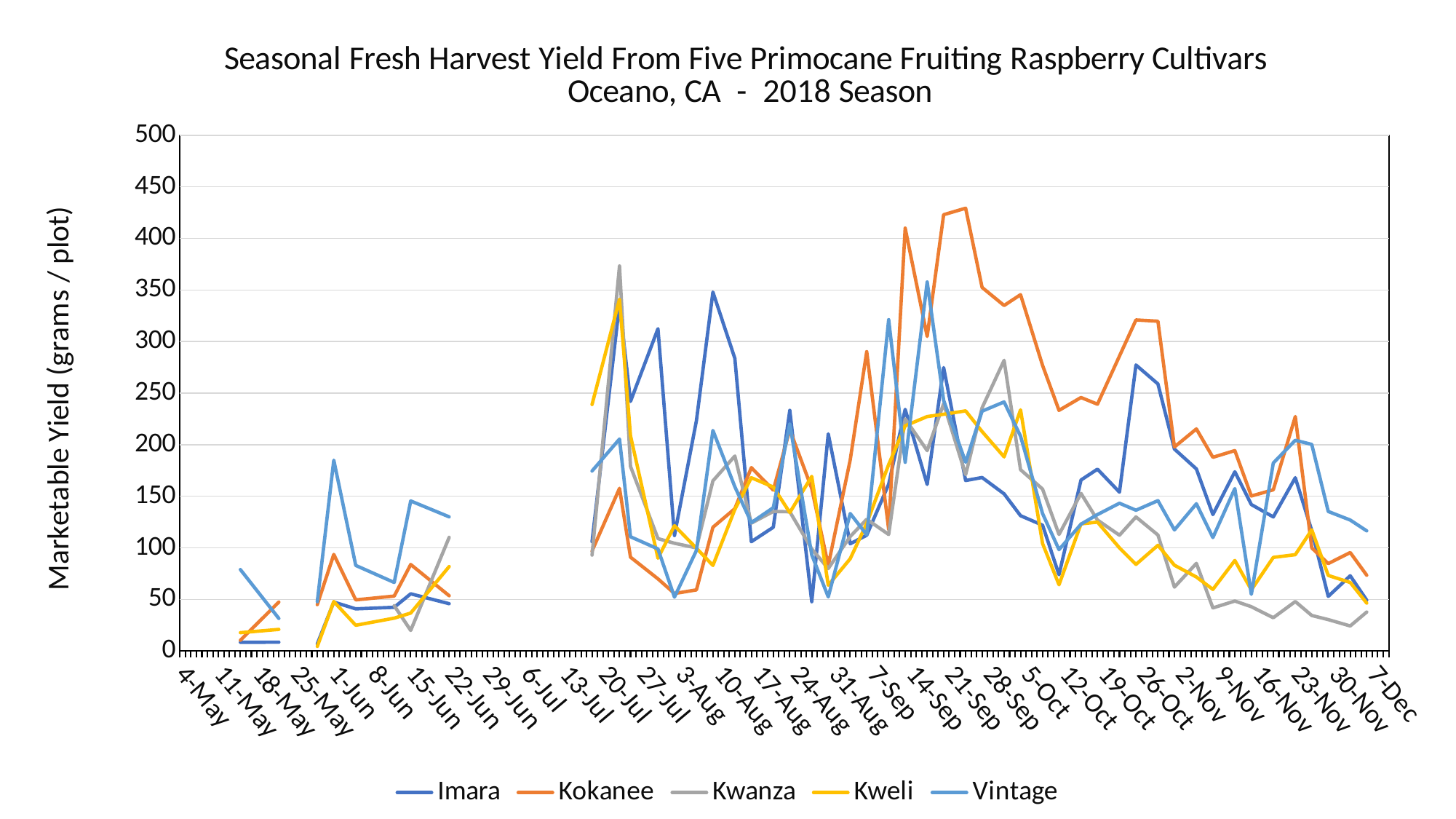
Which cultivar has the highest value at 7-Dec, the last point on the chart? Vintage What is the label on the vertical axis? Marketable Yield (grams / plot) How many series does the legend list? 5 What kind of chart is shown on the slide? line chart Around 21-Sep, which line is higher, Kokanee or Kweli? Kokanee Is the highest value reached by the Imara line greater or less than 300? greater What is the title of the chart? Seasonal Fresh Harvest Yield From Five Primocane Fruiting Raspberry Cultivars Oceano, CA - 2018 Season Is the highest value reached by the Kwanza line greater or less than 350? greater Is the highest value reached by the Vintage line greater or less than 400? less Which cultivar's line reaches the highest value anywhere on the chart? Kokanee Does the Kokanee line generally rise or fall between 21-Sep and 12-Oct? fall